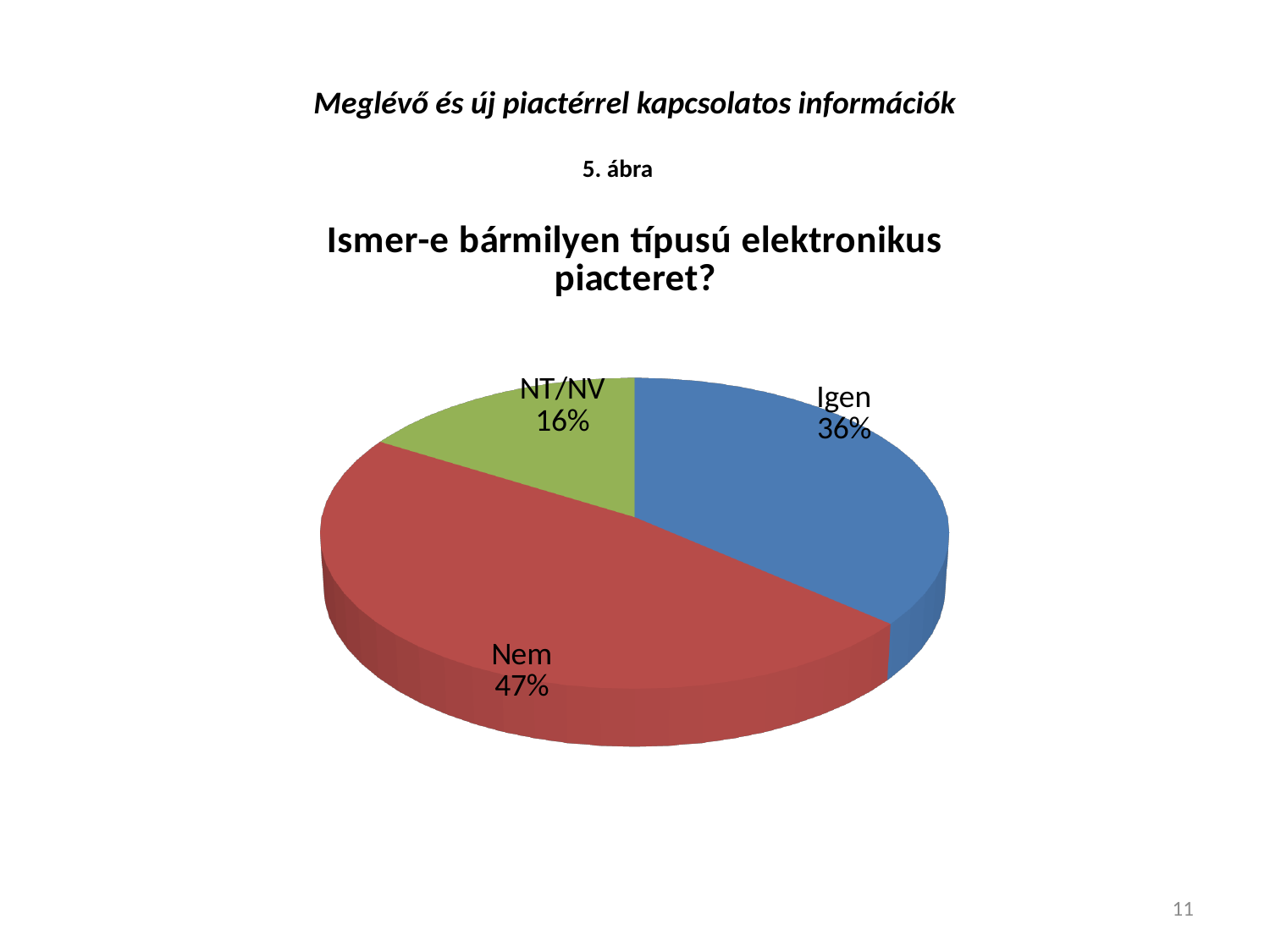
What is the title of the chart? Ismer-e bármilyen típusú elektronikus piacteret? Which category has the largest slice of the pie? Nem Which category has the smallest slice of the pie? NT/NV Which slice is larger, "Nem" or "Igen"? Nem What share of the pie does the "Nem" slice represent? 47% How many slices does the pie chart have? 3 What share of the pie does the "NT/NV" slice represent? 16% What share of the pie does the "Igen" slice represent? 36% Which slice is larger, "Igen" or "NT/NV"? Igen What is the difference in percentage points between the "Igen" and "NT/NV" slices? 20 What is the difference in percentage points between the "Nem" and "Igen" slices? 11 What kind of chart is shown on the slide? Pie chart